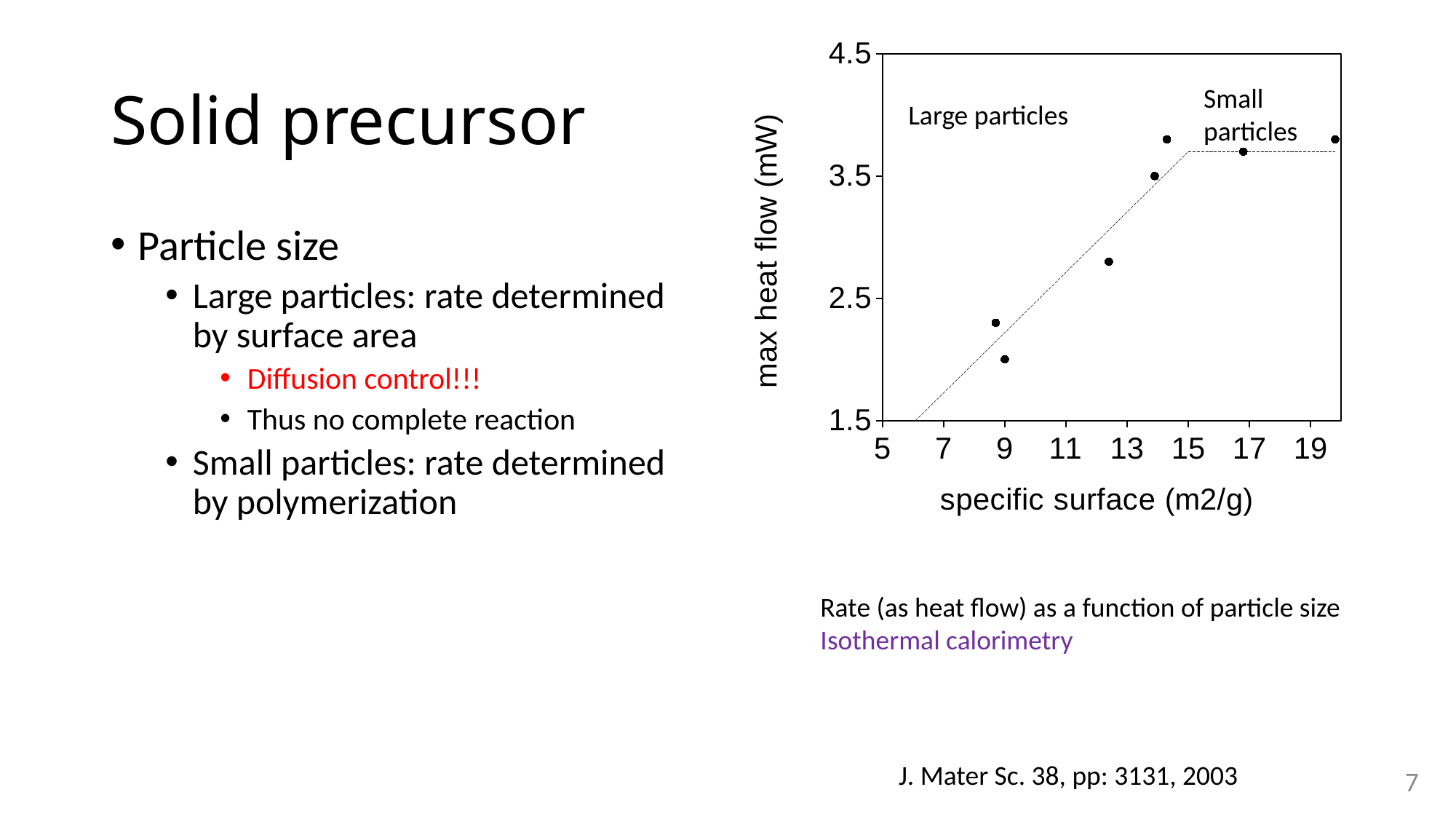
Which has the larger max heat flow: the point near 9 m2/g or the point near 14 m2/g specific surface? the point near 14 m2/g What is the label of the x axis of the chart? specific surface (m2/g) Is the max heat flow of the point near 12 m2/g specific surface greater or less than 2.5 mW? greater Do the plotted values of max heat flow generally rise or fall as specific surface increases along the x axis? rise Is the max heat flow of the point near 17 m2/g specific surface greater or less than 3.5 mW? greater How many data points are plotted on the chart? 7 Is the max heat flow of the point with the largest specific surface (near 19 m2/g) greater or less than 3.5 mW? greater What is the label of the y axis of the chart? max heat flow (mW) What is the highest value shown on the y axis of the chart? 4.5 What kind of chart is shown on the slide? scatter chart